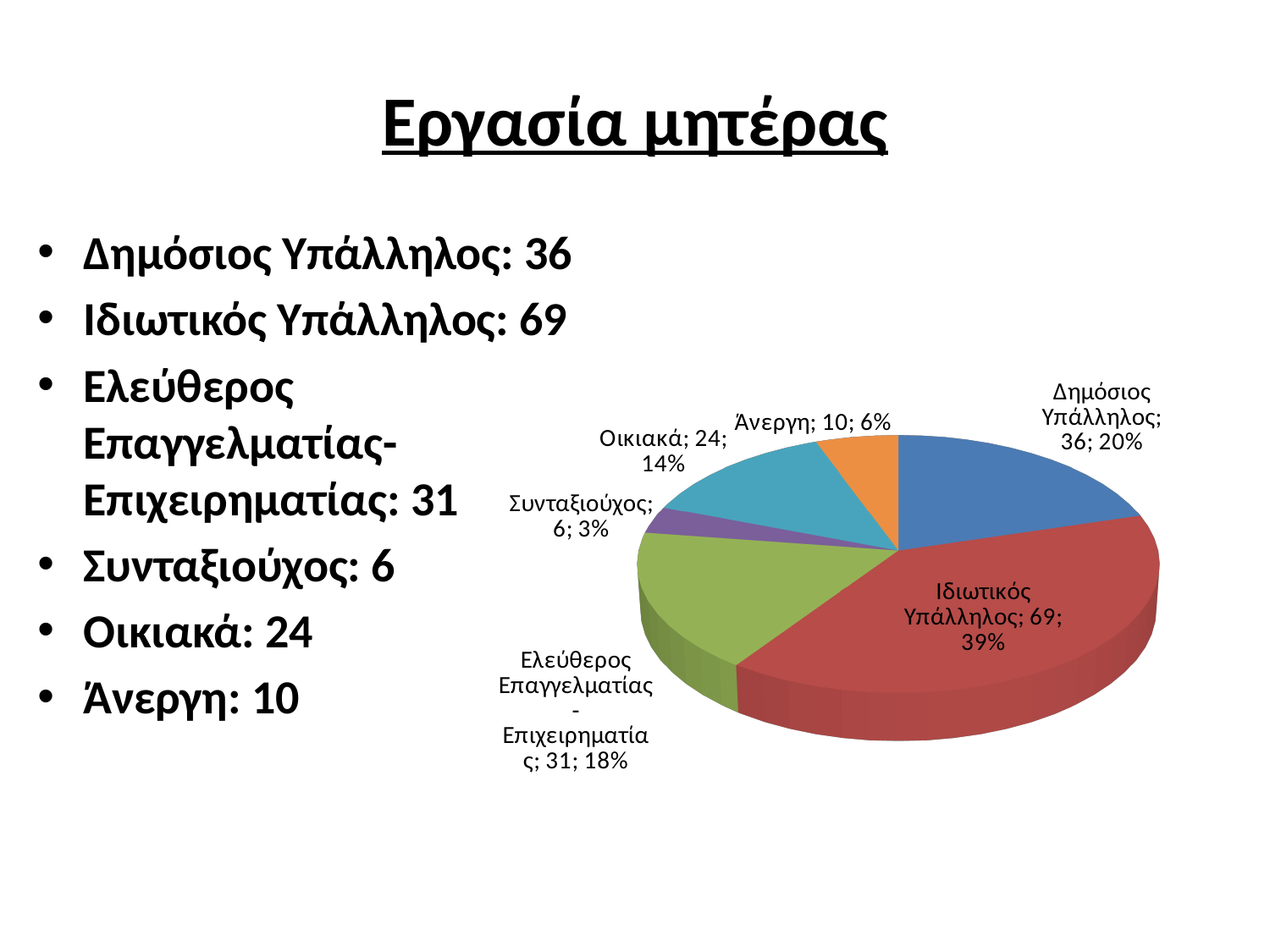
What is the value for Οικιακά in the pie chart? 24 What percentage share does Δημόσιος Υπάλληλος have in the pie chart? 20% How many slices does the pie chart have? 6 What colour is the slice for Ιδιωτικός Υπάλληλος? red What percentage share does Συνταξιούχος have in the pie chart? 3% What is the title of the slide containing the pie chart? Εργασία μητέρας Which category has the largest slice in the pie chart? Ιδιωτικός Υπάλληλος What is the difference between the values for Ιδιωτικός Υπάλληλος and Δημόσιος Υπάλληλος? 33 What is the value for Ιδιωτικός Υπάλληλος in the pie chart? 69 Which category has the smallest slice in the pie chart? Συνταξιούχος Which is larger, the value for Οικιακά or the value for Άνεργη? Οικιακά What kind of chart is shown on the slide? pie chart